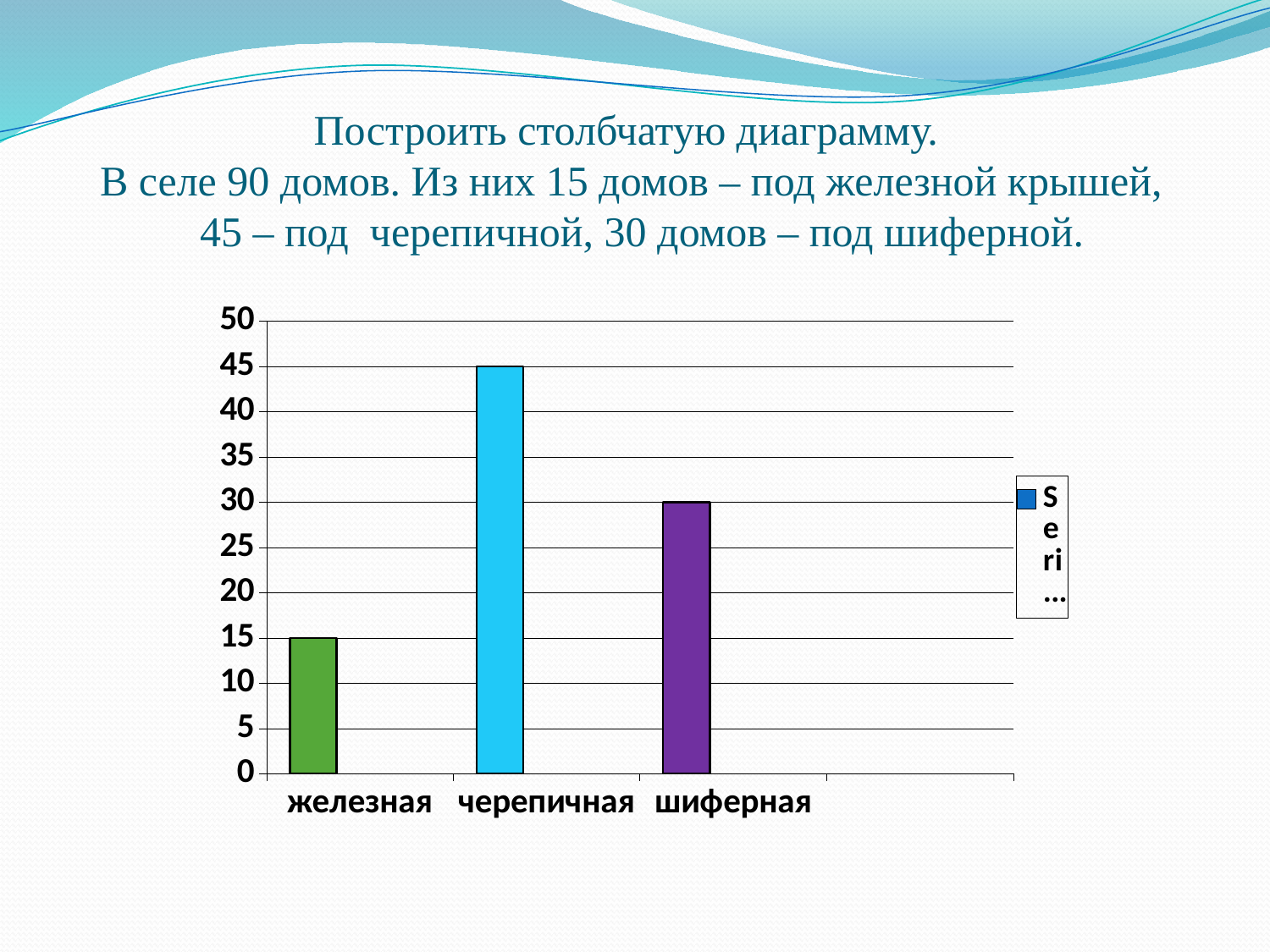
Which category has the lowest value? железная What is the value for шиферная? 30 What colour is the bar for черепичная? light blue What is the difference between the values for черепичная and шиферная? 15 Which is larger, the value for шиферная or the value for железная? шиферная How many series does the legend list? 1 What is the value for железная? 15 How many categories are shown on the x axis of the chart? 3 What is the value for черепичная? 45 Is the value for шиферная greater or less than 20? greater Which category has the highest value? черепичная What type of chart is shown on the slide? bar chart